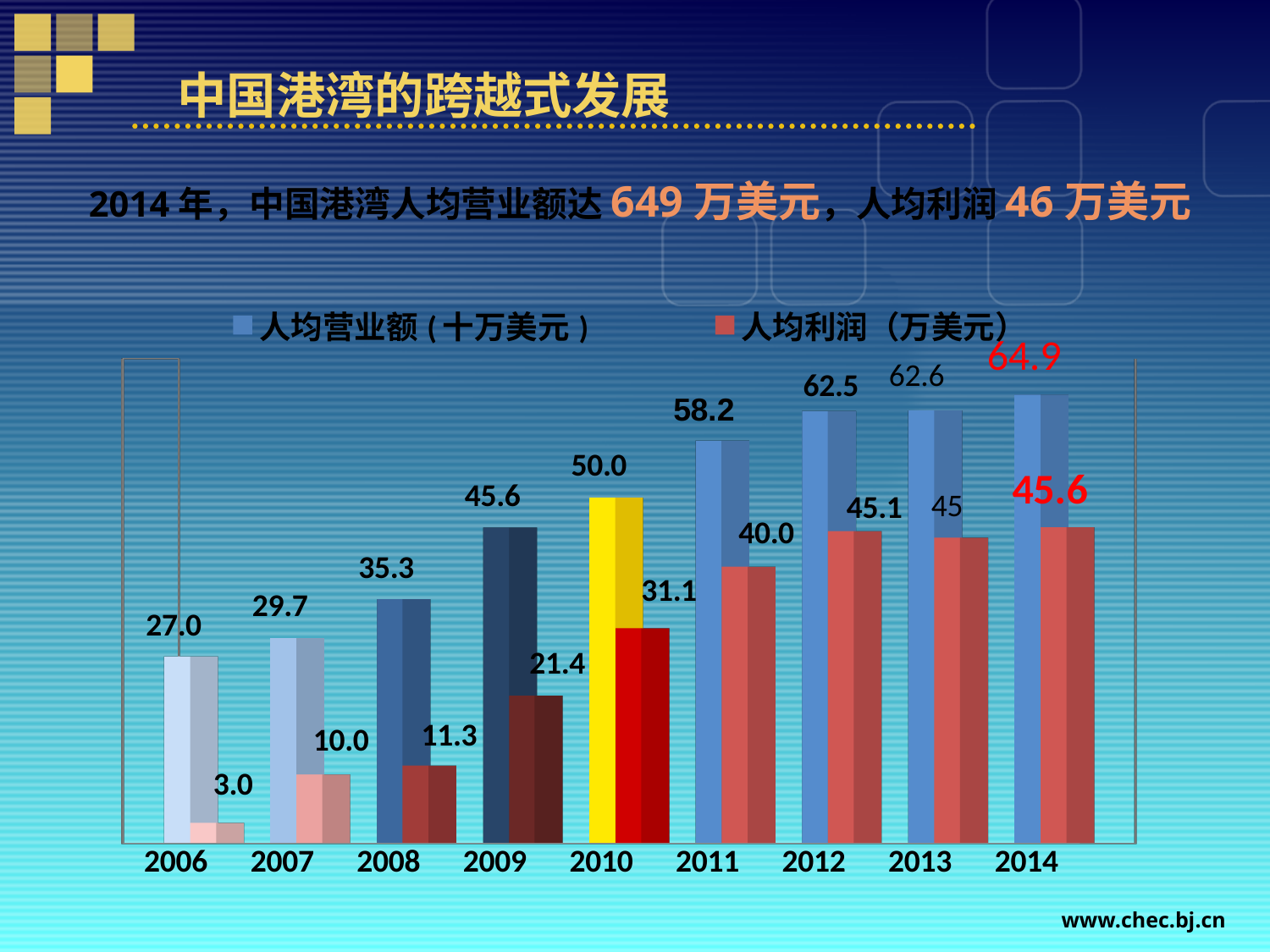
What is the 人均营业额 (十万美元) value for 2010? 50.0 Which year has the lowest 人均利润 (万美元) value? 2006 What is the 人均利润 (万美元) value for 2014? 45.6 What is the 人均利润 (万美元) value for 2009? 21.4 How many years are shown on the x axis of the chart? 9 Do the 人均营业额 (十万美元) values rise or fall from 2006 to 2014? rise What is the difference between the 人均营业额 (十万美元) values for 2014 and 2006? 37.9 What is the difference between the 人均利润 (万美元) values for 2011 and 2010? 8.9 How many series does the chart legend list? 2 What kind of chart is shown on the slide? bar chart Which is larger, the 人均利润 (万美元) value for 2008 or for 2009? 2009 Which year has the highest 人均营业额 (十万美元) value? 2014